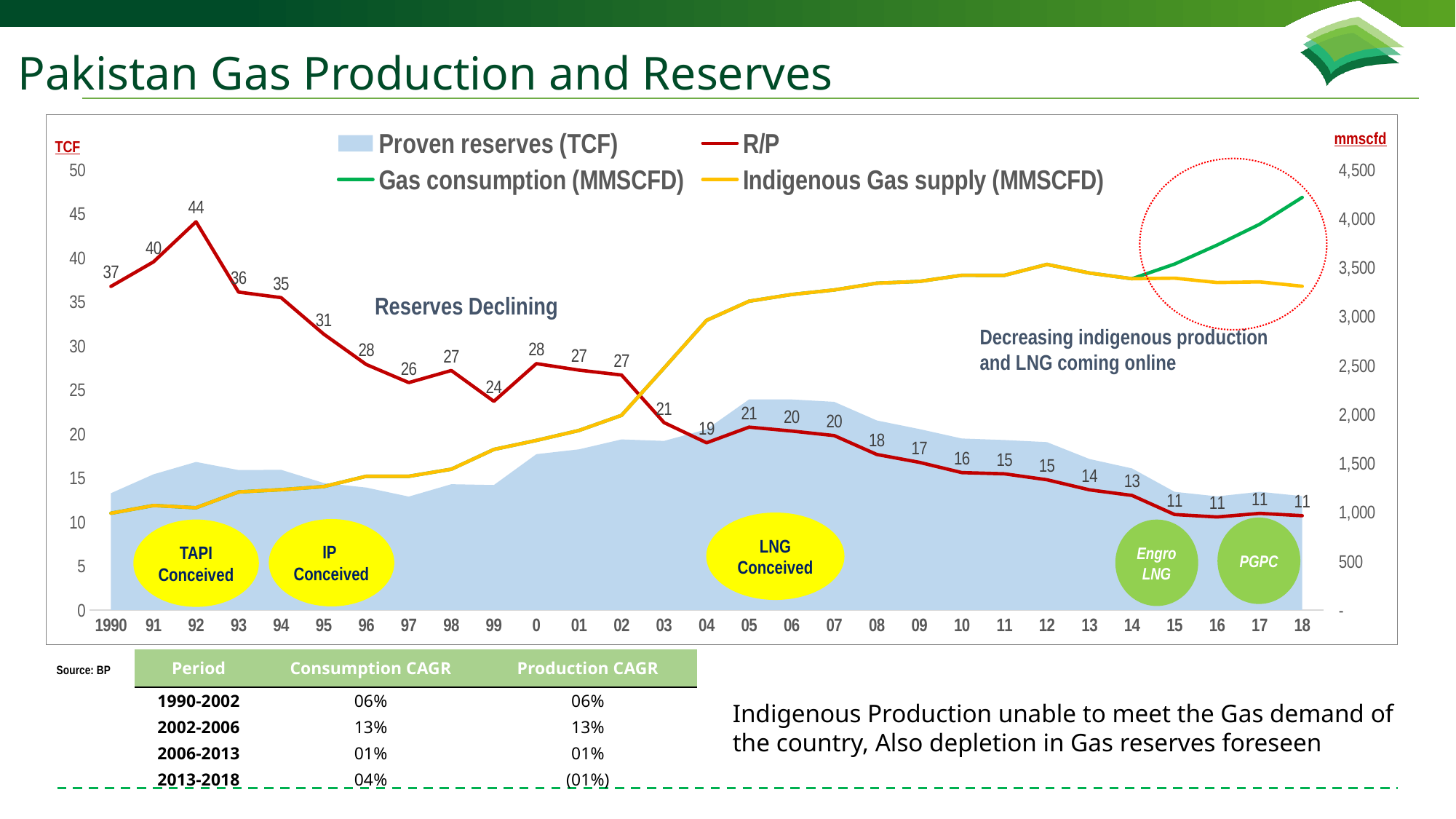
What is the difference between the R/P value in 1990 and in 2018? 26 In which year is the R/P value highest? 1992 Is the Proven reserves (TCF) value for 1990 greater or less than 15? less Which is larger, the R/P value in 1995 or in 2005? 1995 What is the R/P value for 2014? 13 Does the R/P value rise or fall overall from 1990 to 2018? fall Which series is drawn in green? Gas consumption (MMSCFD) What is the R/P value for 2003? 21 How many years are shown on the x axis? 29 Is the Gas consumption (MMSCFD) value for 2018 greater or less than 4,000? greater How many series does the legend list? 4 What is the R/P value for 1992? 44